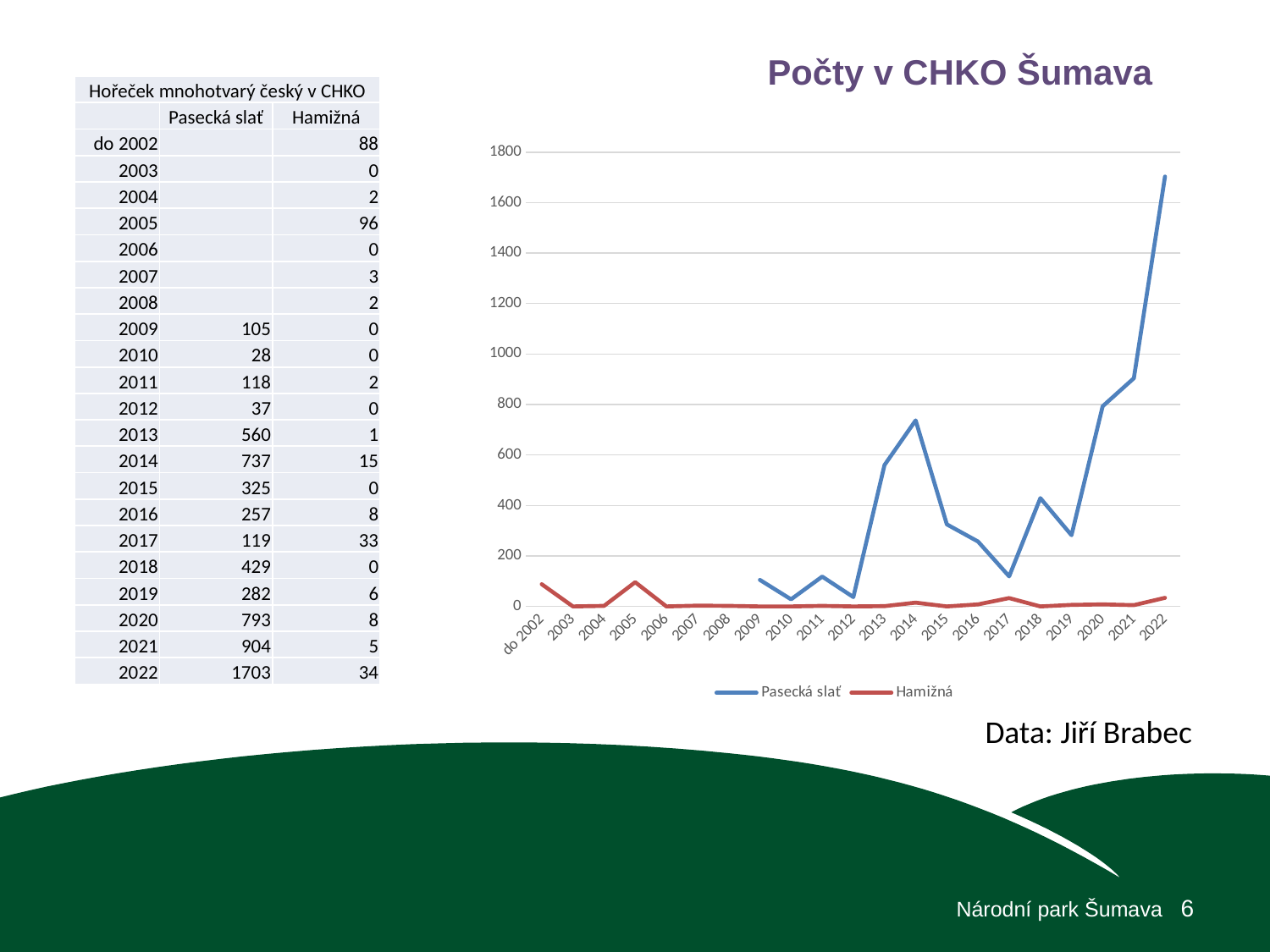
What is the value for Pasecká slať in 2022? 1703 In which year does Pasecká slať reach its highest value? 2022 What is the value for Hamižná in 2005? 96 How many series does the chart legend list? 2 What is the title of the chart? Počty v CHKO Šumava What is the value for Pasecká slať in 2014? 737 What type of chart is shown on the slide? line chart What is the difference between Pasecká slať in 2022 and in 2021? 799 In which year does Hamižná reach its highest value? 2005 Is the value for Pasecká slať in 2020 greater or less than 600? greater What are the two series named in the chart legend? Pasecká slať and Hamižná Which series has the larger value in 2017, Pasecká slať or Hamižná? Pasecká slať